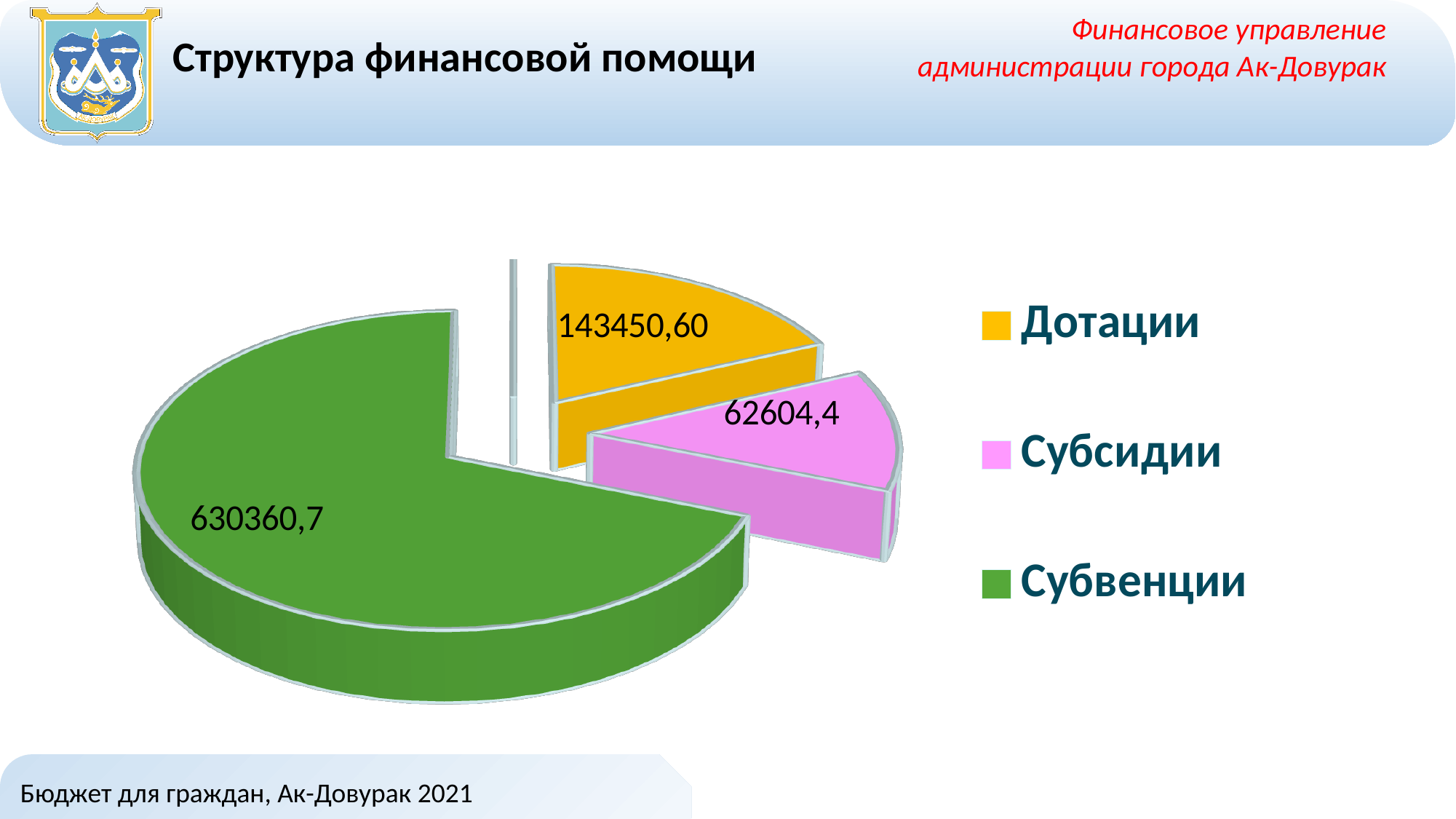
What is the value shown for Субсидии? 62604,4 What is the difference between the values for Дотации and Субсидии? 80846,2 What is the difference between the values for Субвенции and Дотации? 486910,1 What is the title of the chart on the slide? Структура финансовой помощи How many categories does the pie chart have? 3 Which colour represents Субвенции in the legend? Green What type of chart is shown on the slide? Pie chart What is the value shown for Дотации? 143450,60 What is the value shown for Субвенции? 630360,7 Which is larger, Дотации or Субсидии? Дотации Which category has the smallest slice of the pie? Субсидии Which category has the largest slice of the pie? Субвенции